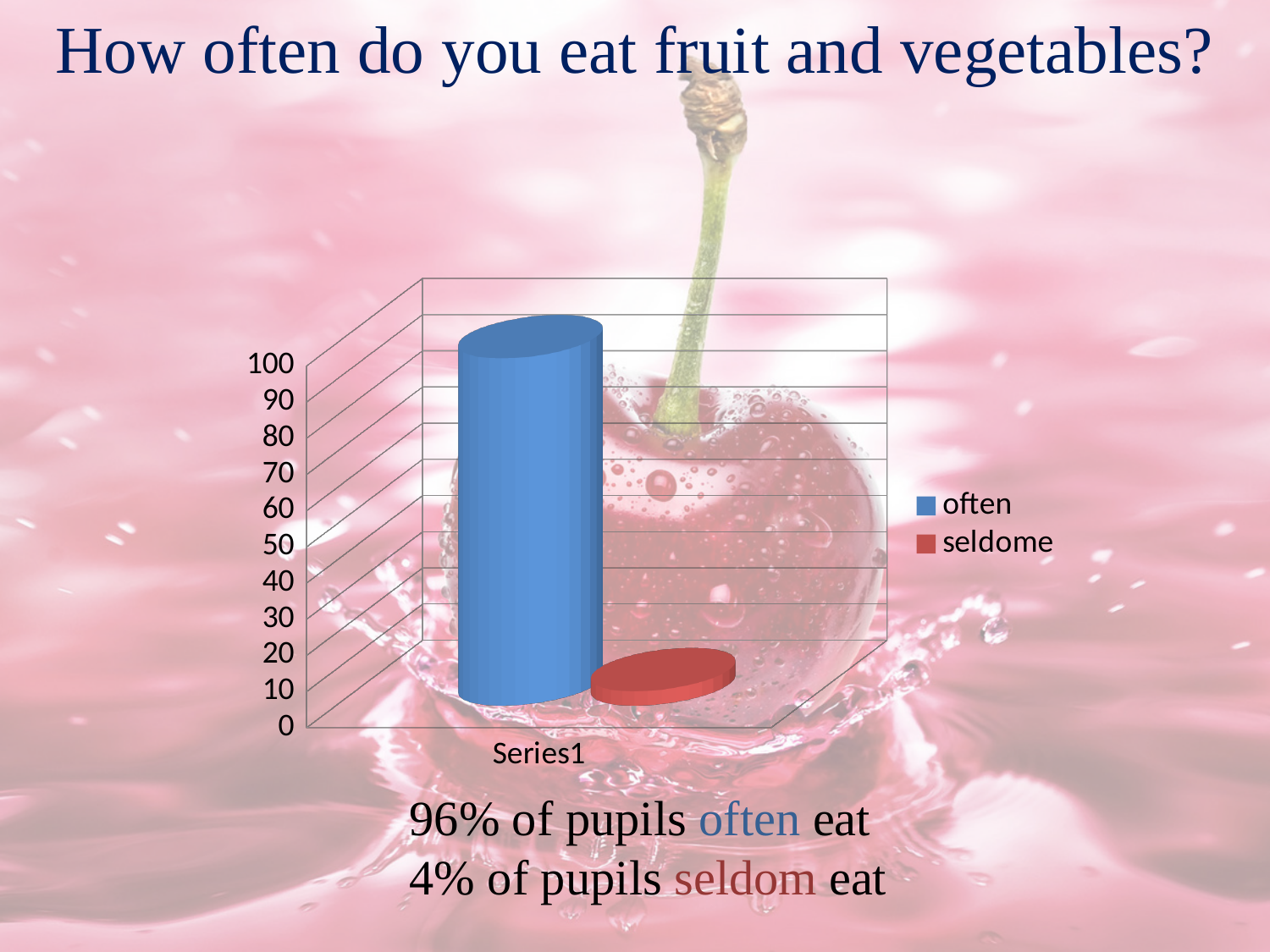
Which series has the highest bar in the chart? often What kind of chart is shown on the slide? bar chart How many category labels are shown on the x axis of the chart? 1 Is the value for often greater or less than 90? greater Which bar is taller, often or seldome? often Is the value for seldome greater or less than 10? less How many series does the chart legend list? 2 According to the slide, what percentage of pupils seldom eat fruit and vegetables? 4% According to the slide, what percentage of pupils often eat fruit and vegetables? 96% Which series has the lowest bar in the chart? seldome What are the two entries in the chart legend? often, seldome What colour is the bar for the often series? blue